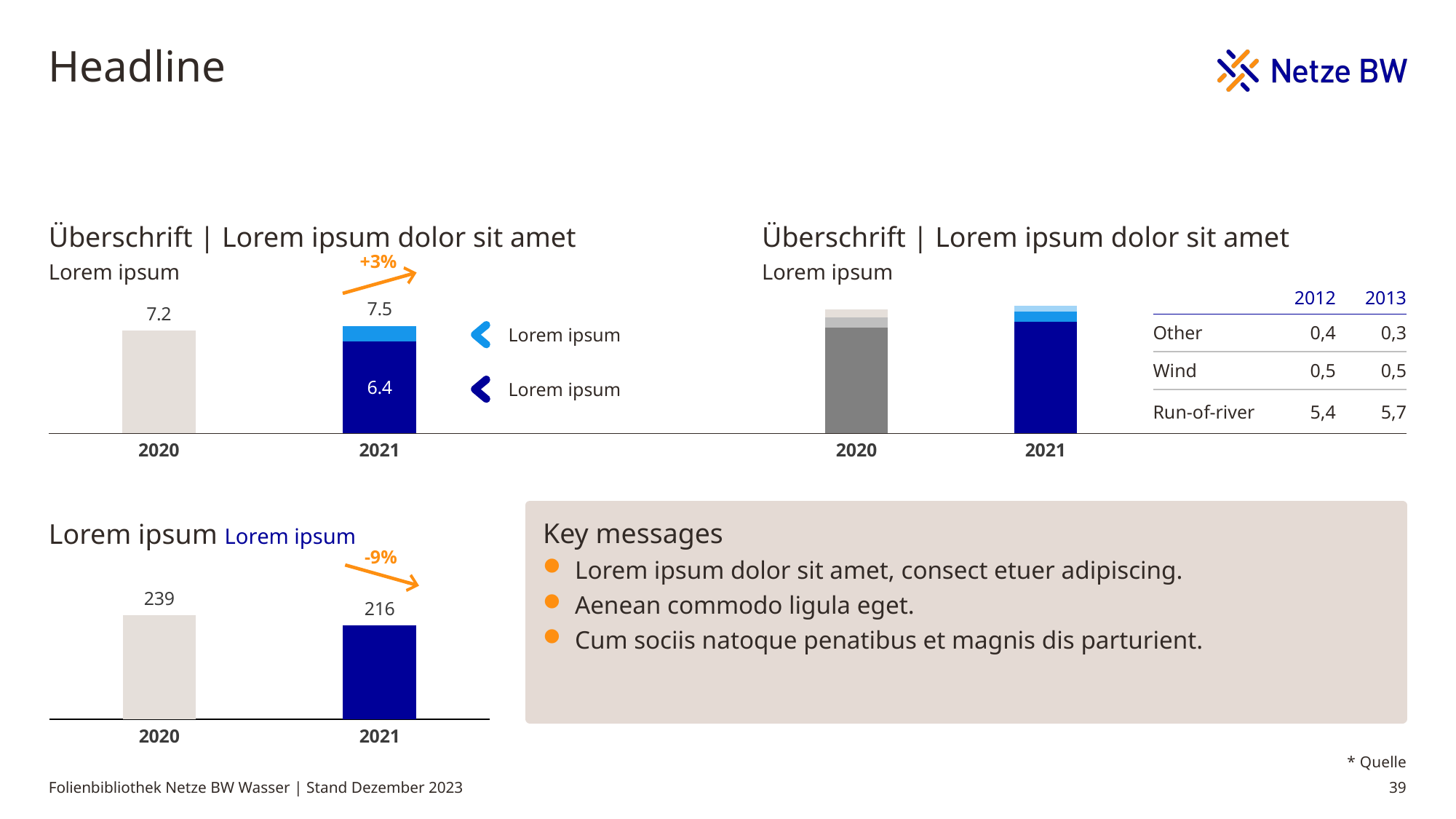
In the table next to the top-right chart, what is the Run-of-river value for 2013? 5,7 What kind of chart is the bottom-left chart? bar chart In the bottom-left chart, what is the difference between the 2020 and 2021 values? 23 In the bottom-left chart, what is the value for 2021? 216 In the bottom-left chart, what percentage change is shown by the orange arrow? -9% In the bottom-left chart, which year has the higher value, 2020 or 2021? 2020 In the top-left chart, what value is printed inside the dark blue segment of the 2021 bar? 6.4 In the top-left chart, what is the value for 2020? 7.2 In the top-left chart, what is the total value of the 2021 bar? 7.5 In the top-left chart, what percentage change is shown by the orange arrow? +3% In the top-left chart, what is the difference between the 2021 total and the 2020 value? 0.3 In the table next to the top-right chart, which row has the lowest value for 2013? Other